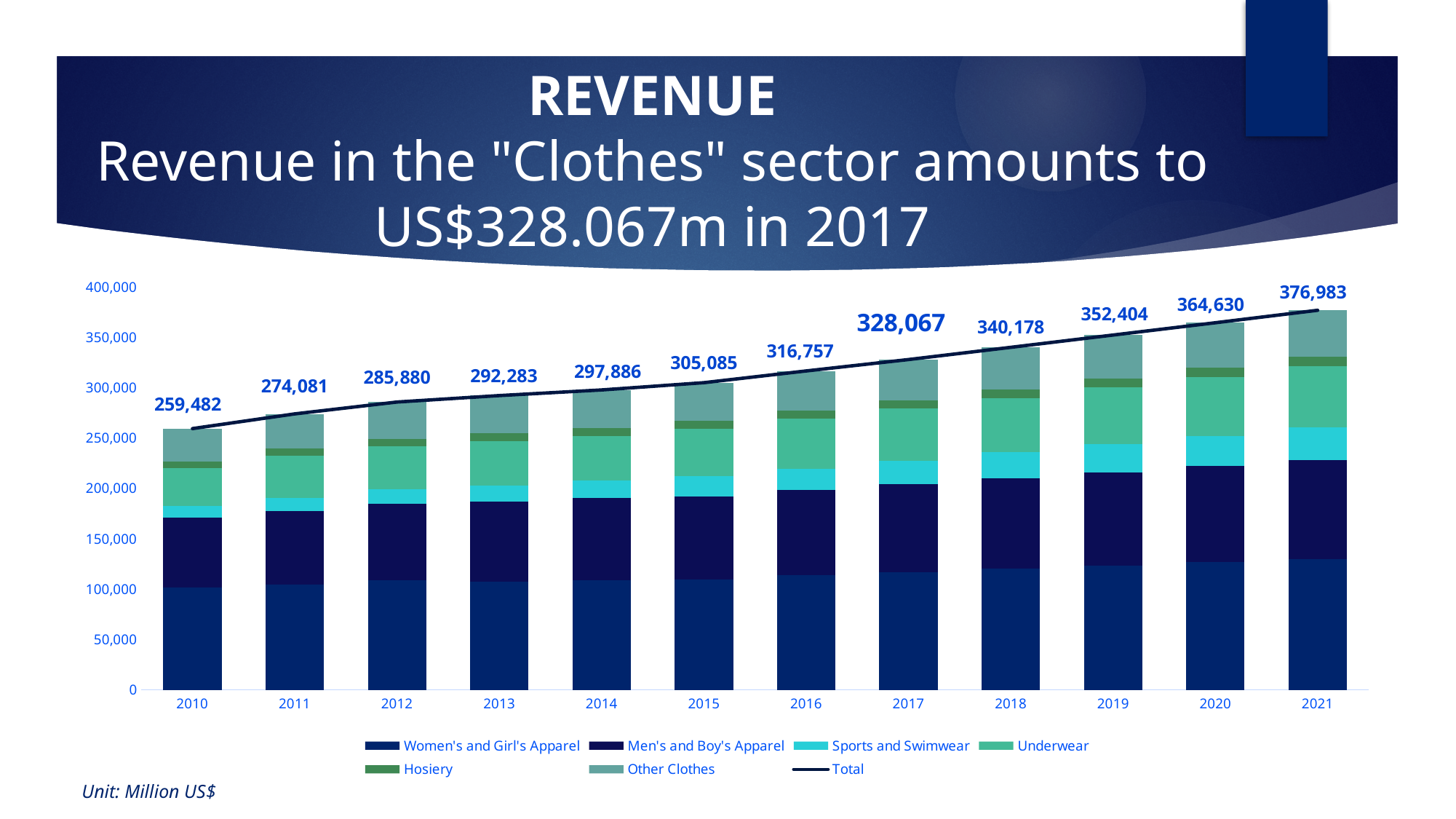
Which year has the lowest Total revenue? 2010 Which year has the highest Total revenue? 2021 What is the Total revenue value shown for 2010? 259,482 What is the Total revenue value shown for 2021? 376,983 What is the Total revenue value shown for 2017? 328,067 Is the value for Women's and Girl's Apparel in 2021 greater or less than 100,000? greater How many years are shown on the x axis? 12 Which is larger, the Total revenue in 2015 or in 2016? 2016 Does the Total revenue rise or fall from 2010 to 2021? Rise How many entries does the legend list? 7 What kind of chart is shown on the slide? Stacked bar chart with a line What is the difference between the Total revenue in 2021 and in 2010? 117,501